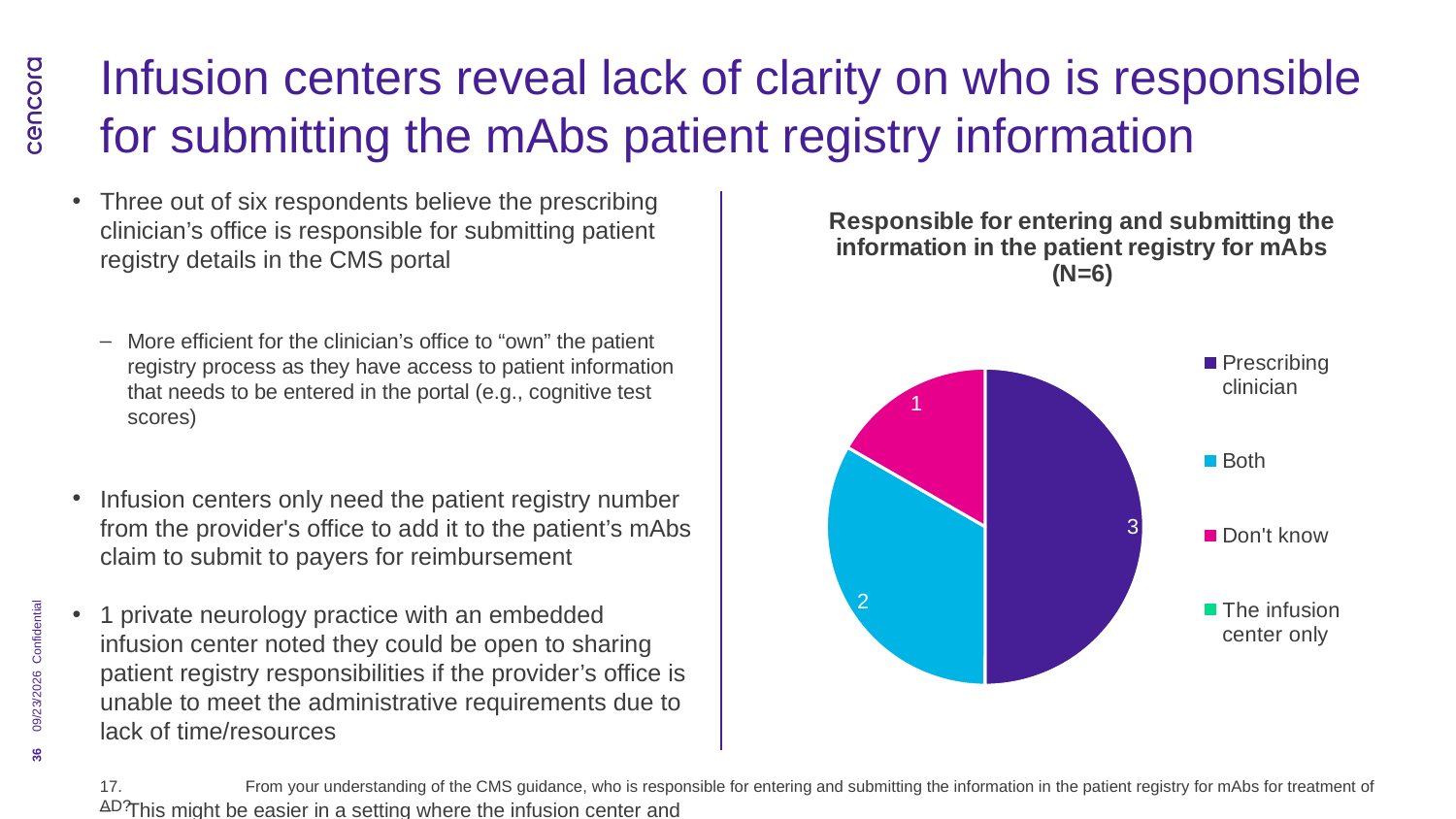
Which is larger in the pie chart: "Both" or "Don't know"? Both What colour is the "Both" slice in the pie chart? Light blue Which category has the largest slice in the pie chart? Prescribing clinician How many entries does the pie chart legend list? 4 What type of chart is shown on the slide? Pie chart What is the N value stated in the pie chart title? N=6 How many respondents selected "Prescribing clinician" in the pie chart? 3 What share of the pie does the "Prescribing clinician" slice represent? 50% How many respondents selected "Don't know" in the pie chart? 1 What is the difference between the "Prescribing clinician" and "Both" values in the pie chart? 1 How many respondents selected "Both" in the pie chart? 2 Which of the labelled slices is the smallest in the pie chart? Don't know